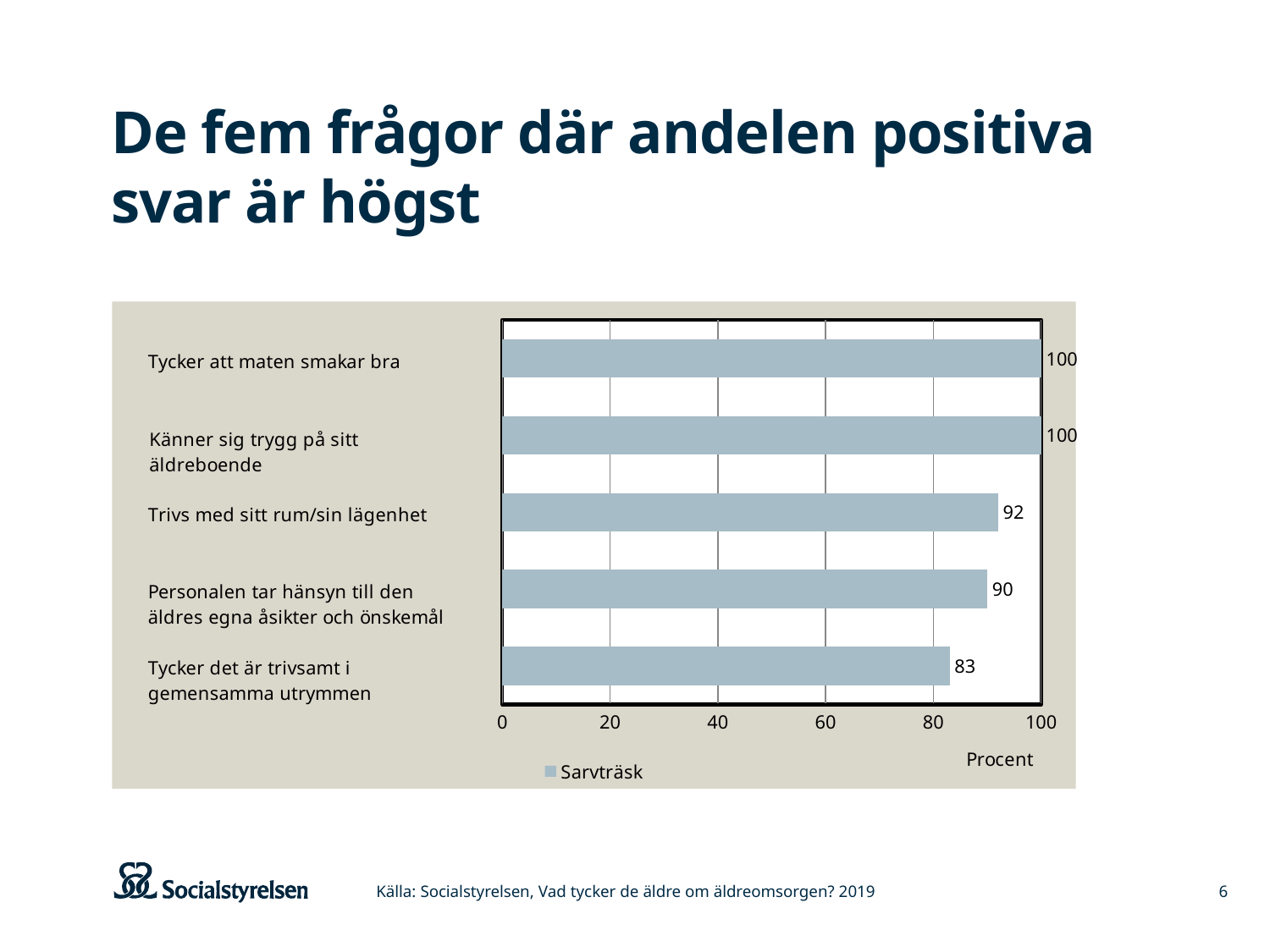
What is the value for "Tycker det är trivsamt i gemensamma utrymmen"? 83 What is the name of the series shown in the legend? Sarvträsk What is the difference between the values for "Känner sig trygg på sitt äldreboende" and "Personalen tar hänsyn till den äldres egna åsikter och önskemål"? 10 What is the value for "Trivs med sitt rum/sin lägenhet"? 92 Which is larger: the value for "Trivs med sitt rum/sin lägenhet" or the value for "Tycker det är trivsamt i gemensamma utrymmen"? Trivs med sitt rum/sin lägenhet What is the value for "Personalen tar hänsyn till den äldres egna åsikter och önskemål"? 90 How many categories are shown in the chart? 5 What kind of chart is shown on the slide? Bar chart How many series does the legend list? 1 Which category has the lowest value? Tycker det är trivsamt i gemensamma utrymmen What is the value for "Tycker att maten smakar bra"? 100 What is the difference between the values for "Trivs med sitt rum/sin lägenhet" and "Tycker det är trivsamt i gemensamma utrymmen"? 9